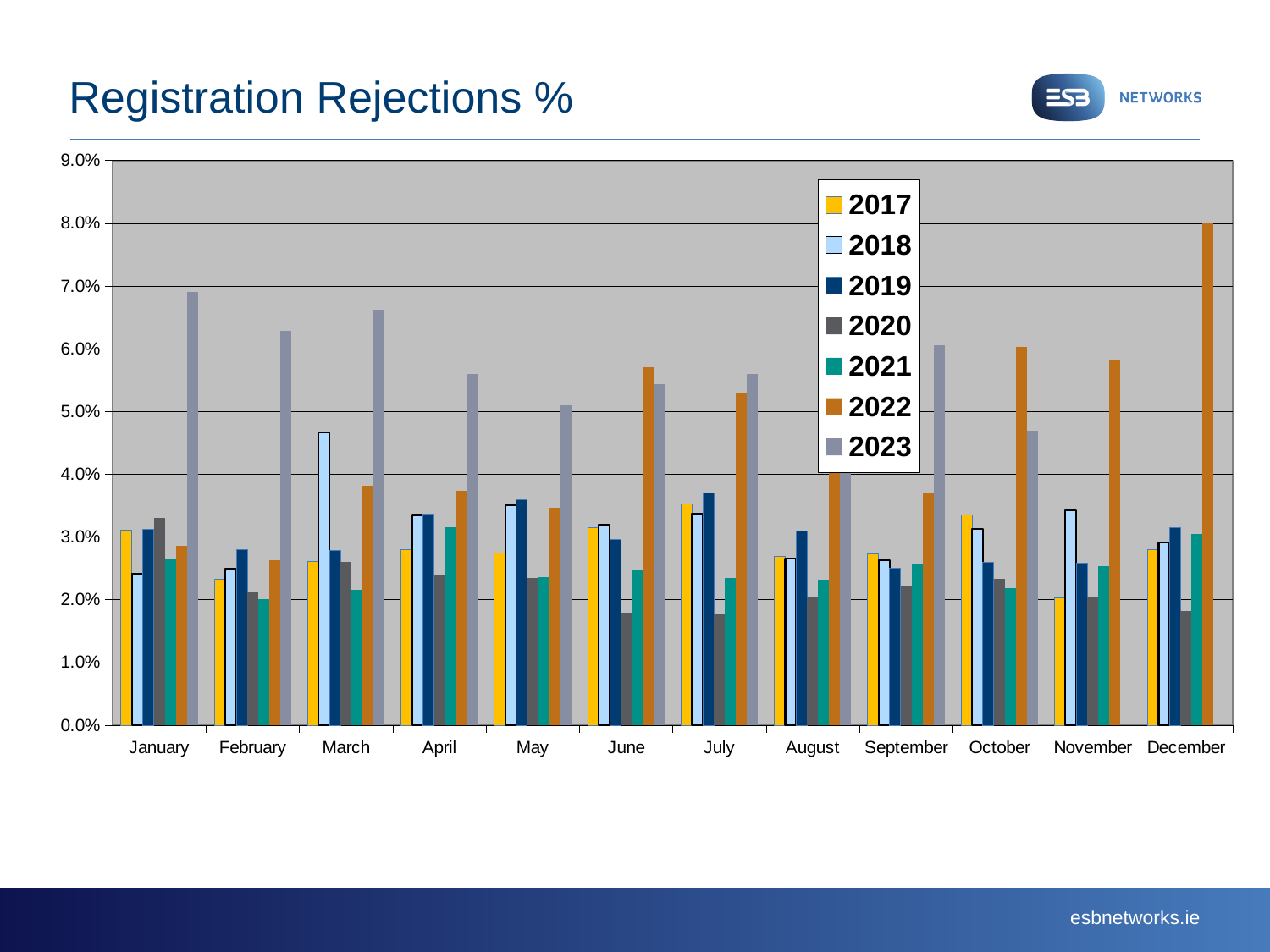
Is the value for 2018 in March greater or less than 4.0%? greater Which is larger in September, the value for 2022 or the value for 2023? 2023 How many months are shown along the x axis? 12 How many series does the legend list? 7 What kind of chart is shown on the slide? bar chart Is the value for 2020 in December greater or less than 2.0%? less Is the value for 2022 in December greater or less than 7.0%? greater Which year has the highest bar in December? 2022 In which month is the 2022 value highest? December What is the title of the chart? Registration Rejections % Which is larger in October, the value for 2022 or the value for 2023? 2022 In which month is the 2023 value highest? January